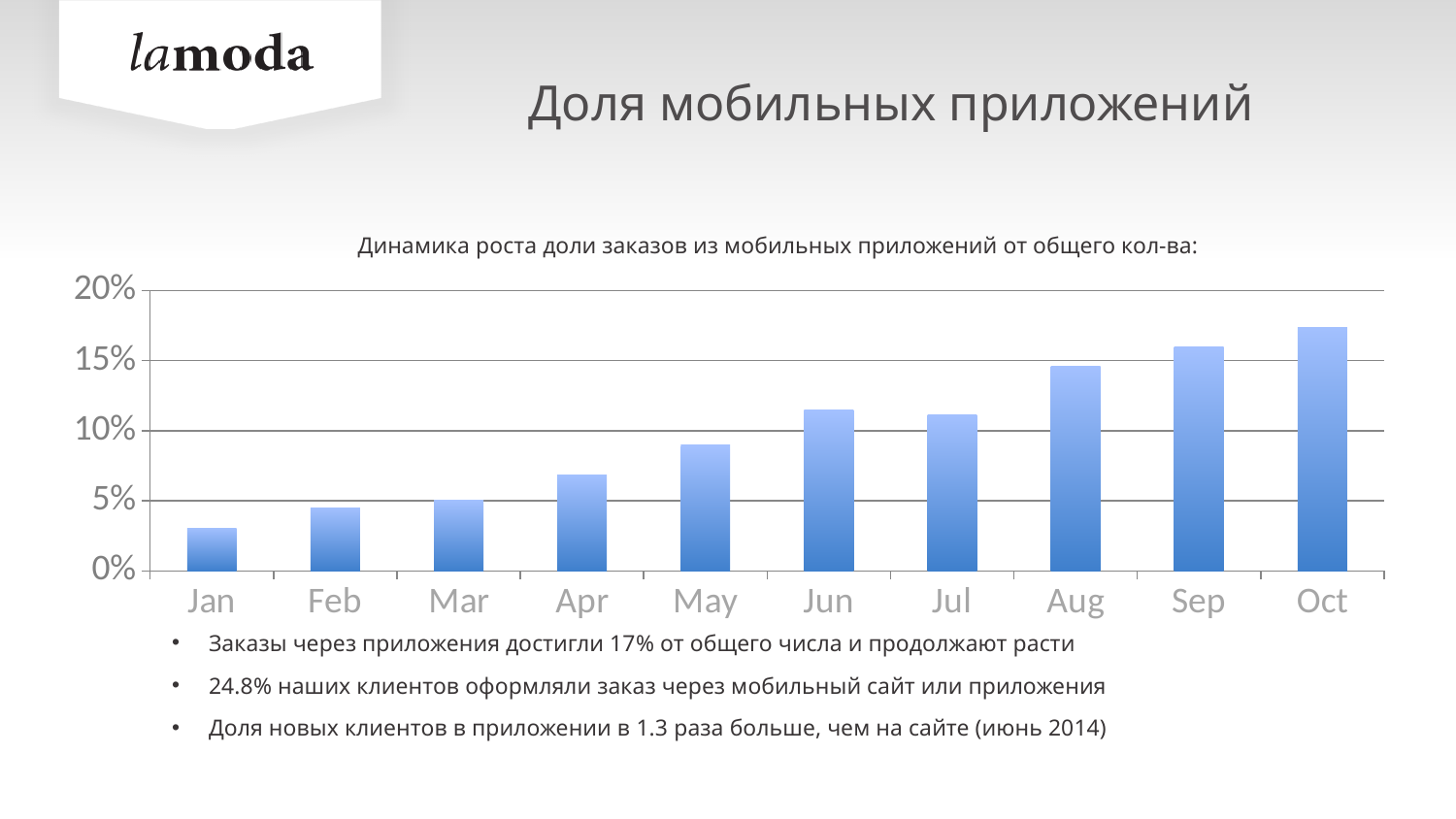
Which month has the lowest bar in the chart? Jan What is the title of the slide containing the chart? Доля мобильных приложений Is the value for Oct greater or less than 20%? less Do the values generally rise or fall from Jan to Oct? rise Is the value for Jun greater or less than 10%? greater What kind of chart is shown on the slide? bar chart How many months are shown on the x axis of the chart? 10 Which month has the highest bar in the chart? Oct Which is larger, the value for Aug or the value for Jul? Aug Is the value for Sep greater or less than 15%? greater